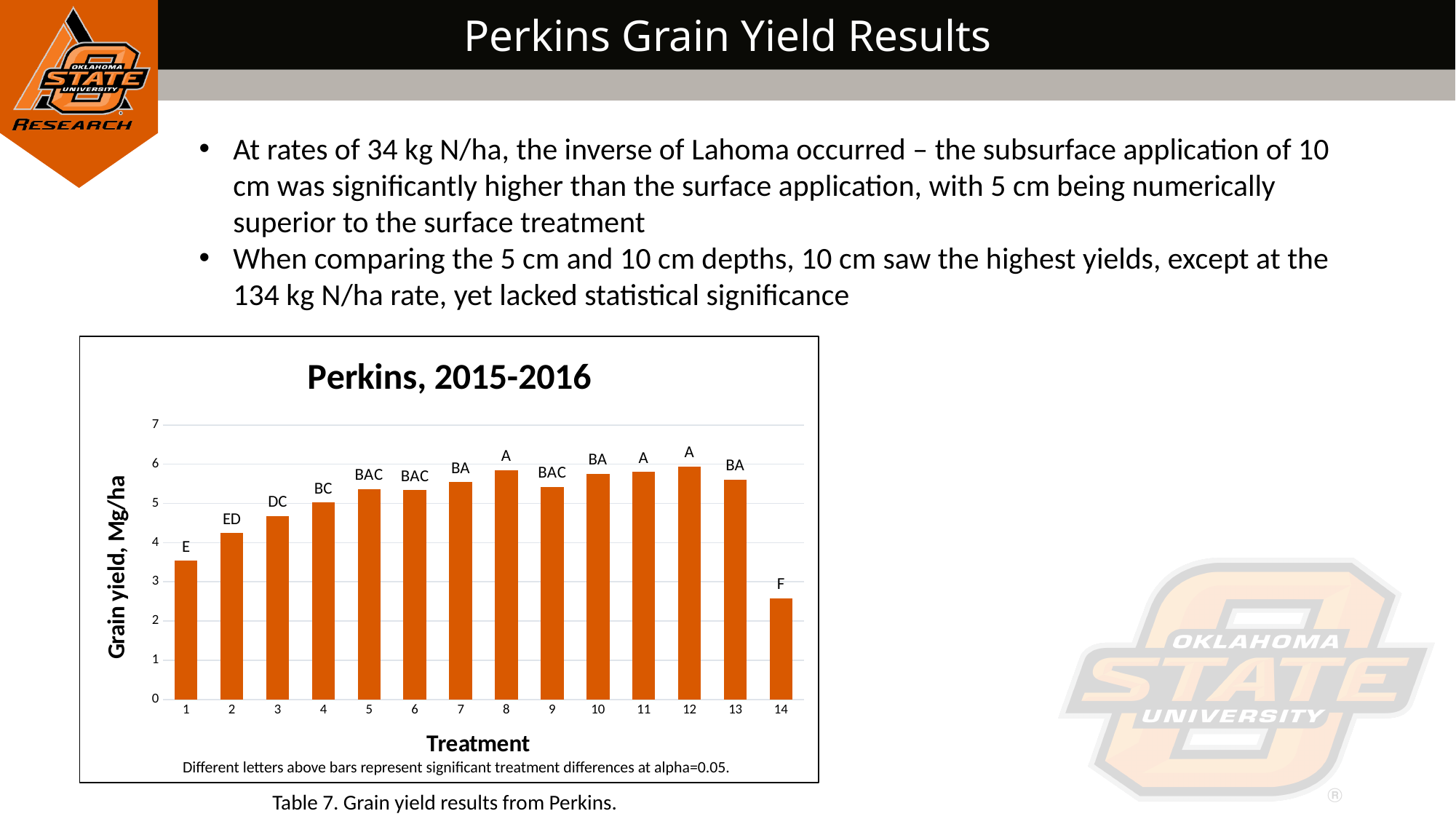
Is the grain yield for treatment 8 greater or less than 5 Mg/ha? greater Is the grain yield for treatment 3 greater or less than 5 Mg/ha? less What significance letter is printed above the bar for treatment 14? F What kind of chart is shown on the slide? bar chart How many treatments are plotted on the x axis of the chart? 14 Which has the higher grain yield, treatment 13 or treatment 14? treatment 13 What is the label on the y axis of the chart? Grain yield, Mg/ha Is the grain yield for treatment 14 greater or less than 3 Mg/ha? less Which treatment has the lowest grain yield in the chart? 14 Which has the higher grain yield, treatment 2 or treatment 7? treatment 7 What is the title of the chart? Perkins, 2015-2016